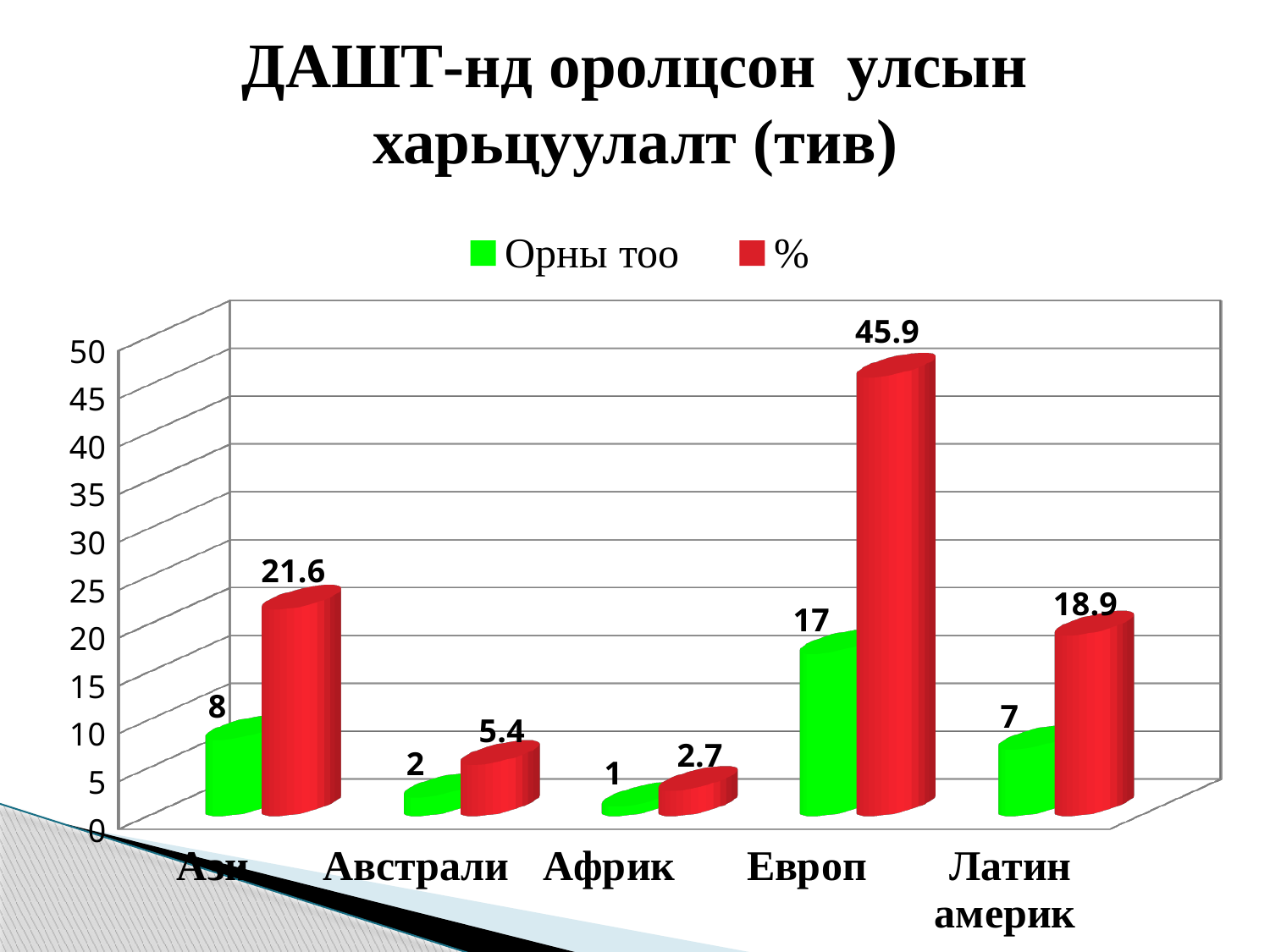
Which is larger: the Орны тоо value for Ази or for Латин америк? Ази How many categories are shown on the x axis? 5 Which category has the highest % value? Европ What is the value of Орны тоо for Африк? 1 What is the difference between the % values for Европ and Латин америк? 27 What is the value of Орны тоо for Европ? 17 What is the % value for Австрали? 5.4 How many series does the legend list? 2 What kind of chart is shown on the slide? Bar chart Which colour represents the % series in the legend? Red Which category has the lowest Орны тоо value? Африк What is the % value for Латин америк? 18.9